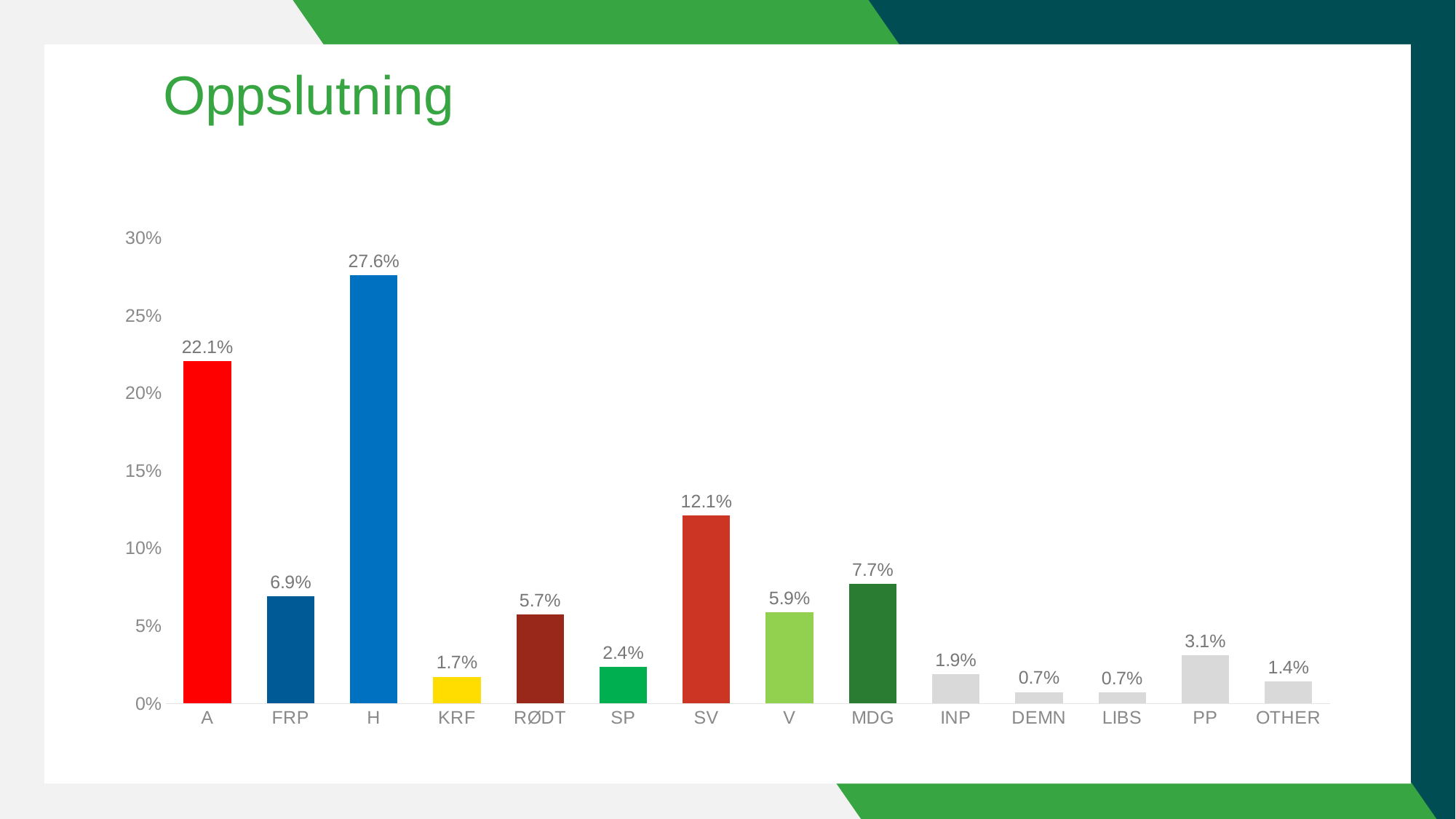
What is the difference between the values for SV and MDG? 4.4% What is the value for MDG? 7.7% What is the value for SV? 12.1% How many categories are shown on the x axis? 14 What is the difference between the values for H and A? 5.5% Which categories share the lowest value? DEMN and LIBS Which category has the highest value? H Which is larger, the value for FRP or the value for V? FRP What kind of chart is shown on the slide? bar chart What is the title of the slide? Oppslutning What is the value for H? 27.6% Is the value for A greater or less than 20%? greater